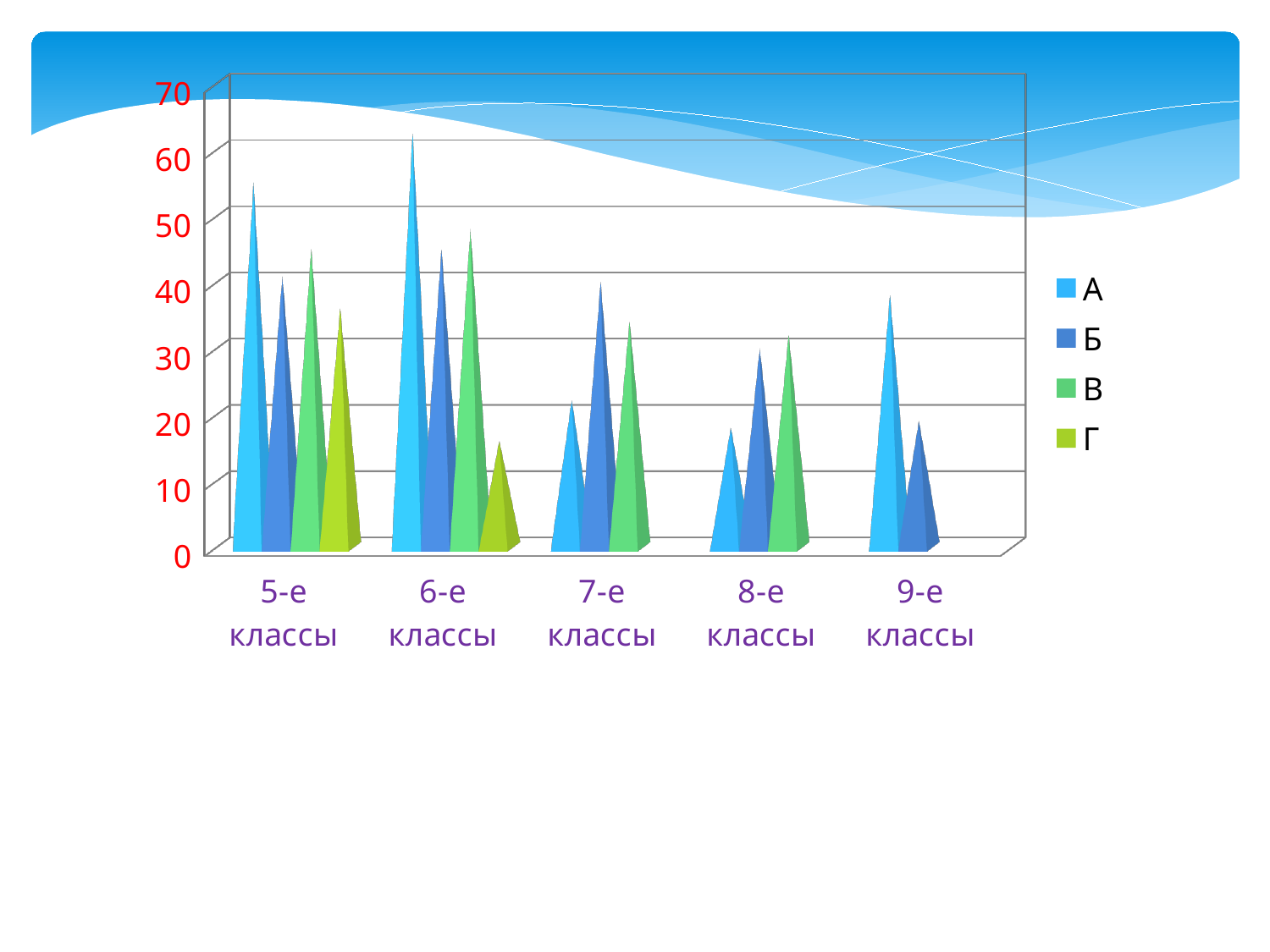
How many categories are shown on the x axis? 5 Is the value for series Г in 6-е классы greater or less than 20? less In 5-е классы, which is larger: series А or series Б? А Is the value for series В in 8-е классы greater or less than 20? greater Which category has the highest value for series А? 6-е классы Which categories have a bar for series Г? 5-е классы and 6-е классы How many series does the legend list? 4 What kind of chart is shown on the slide? bar chart Which series has the tallest bar in the whole chart? А Is the value for series А in 5-е классы greater or less than 50? greater In 7-е классы, which is larger: series А or series Б? Б